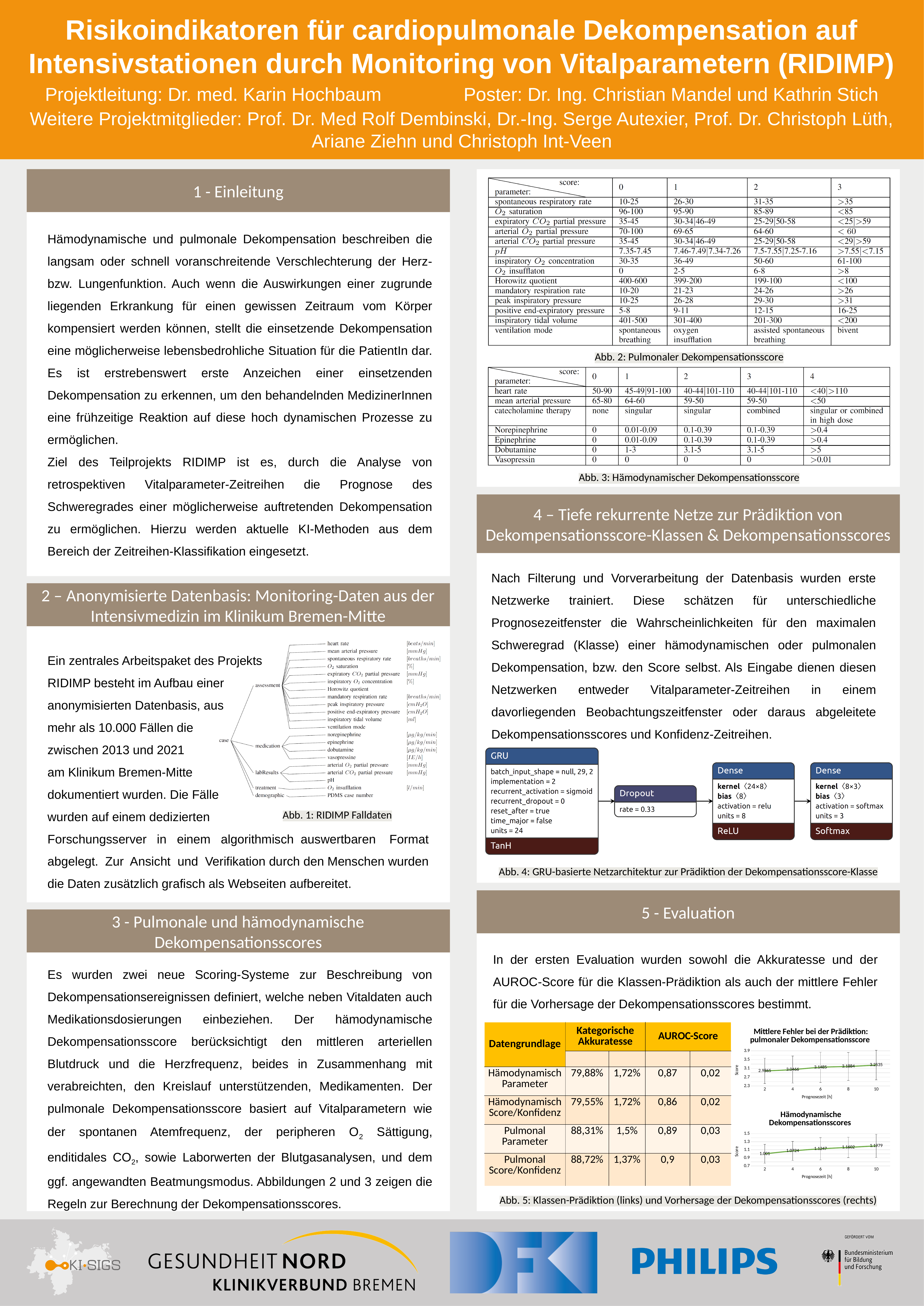
In the 'Mittlere Fehler bei der Prädiktion: pulmonaler Dekompensationsscore' chart, at which Prognosezeit is the value highest? 10 In the 'Hämodynamische Dekompensationsscores' chart, is the value at Prognosezeit 10 h greater or less than 1.3? less In the 'Hämodynamische Dekompensationsscores' chart, at which Prognosezeit is the value lowest? 2 In the 'Hämodynamische Dekompensationsscores' chart, what is the value at Prognosezeit 10 h? 1.1979 In the 'Mittlere Fehler bei der Prädiktion: pulmonaler Dekompensationsscore' chart, do the values rise or fall as Prognosezeit increases? rise How many data points are plotted in the 'Mittlere Fehler bei der Prädiktion: pulmonaler Dekompensationsscore' chart? 5 In the 'Mittlere Fehler bei der Prädiktion: pulmonaler Dekompensationsscore' chart, what is the value at Prognosezeit 10 h? 3.2535 What kind of chart is the 'Mittlere Fehler bei der Prädiktion: pulmonaler Dekompensationsscore' chart? line chart In the 'Hämodynamische Dekompensationsscores' chart, what is the value at Prognosezeit 6 h? 1.1247 In the 'Mittlere Fehler bei der Prädiktion: pulmonaler Dekompensationsscore' chart, what is the value at Prognosezeit 2 h? 2.9865 In the 'Mittlere Fehler bei der Prädiktion: pulmonaler Dekompensationsscore' chart, what is the difference between the values at 10 h and 2 h? 0.267 What is the label of the x axis in the 'Hämodynamische Dekompensationsscores' chart? Prognosezeit [h]